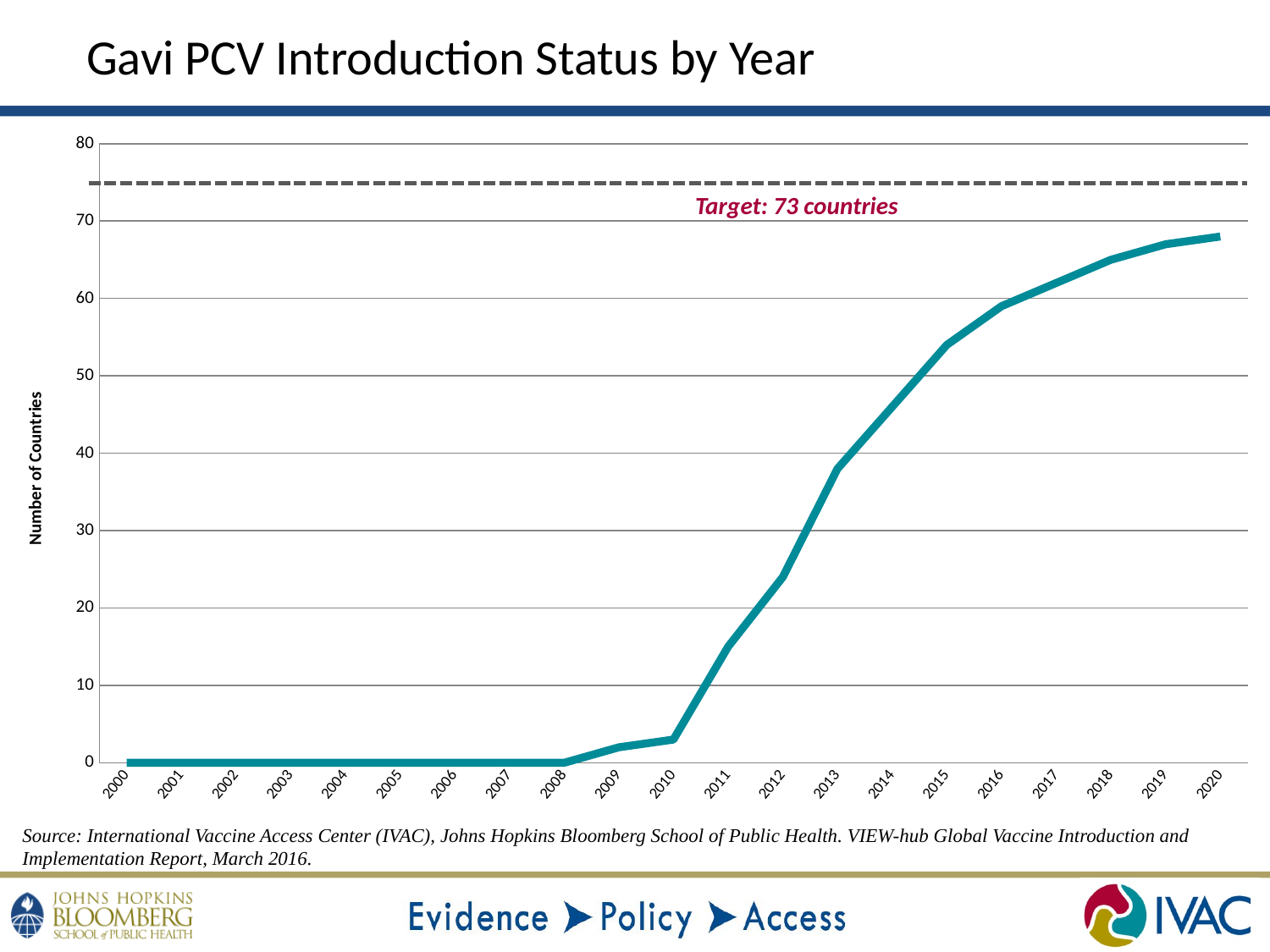
Is the value for 2011 greater or less than 20? less What is the label on the y axis? Number of Countries What is the number of countries in 2000? 0 What is the title of the chart? Gavi PCV Introduction Status by Year Does the number of countries rise or fall from 2010 to 2020? Rise What kind of chart is shown on the slide? Line chart Is the value for 2013 greater or less than 30? greater Is the value for 2020 greater or less than 70? less What is the number of countries in 2008? 0 Which year has the highest number of countries? 2020 How many years are shown on the x axis? 21